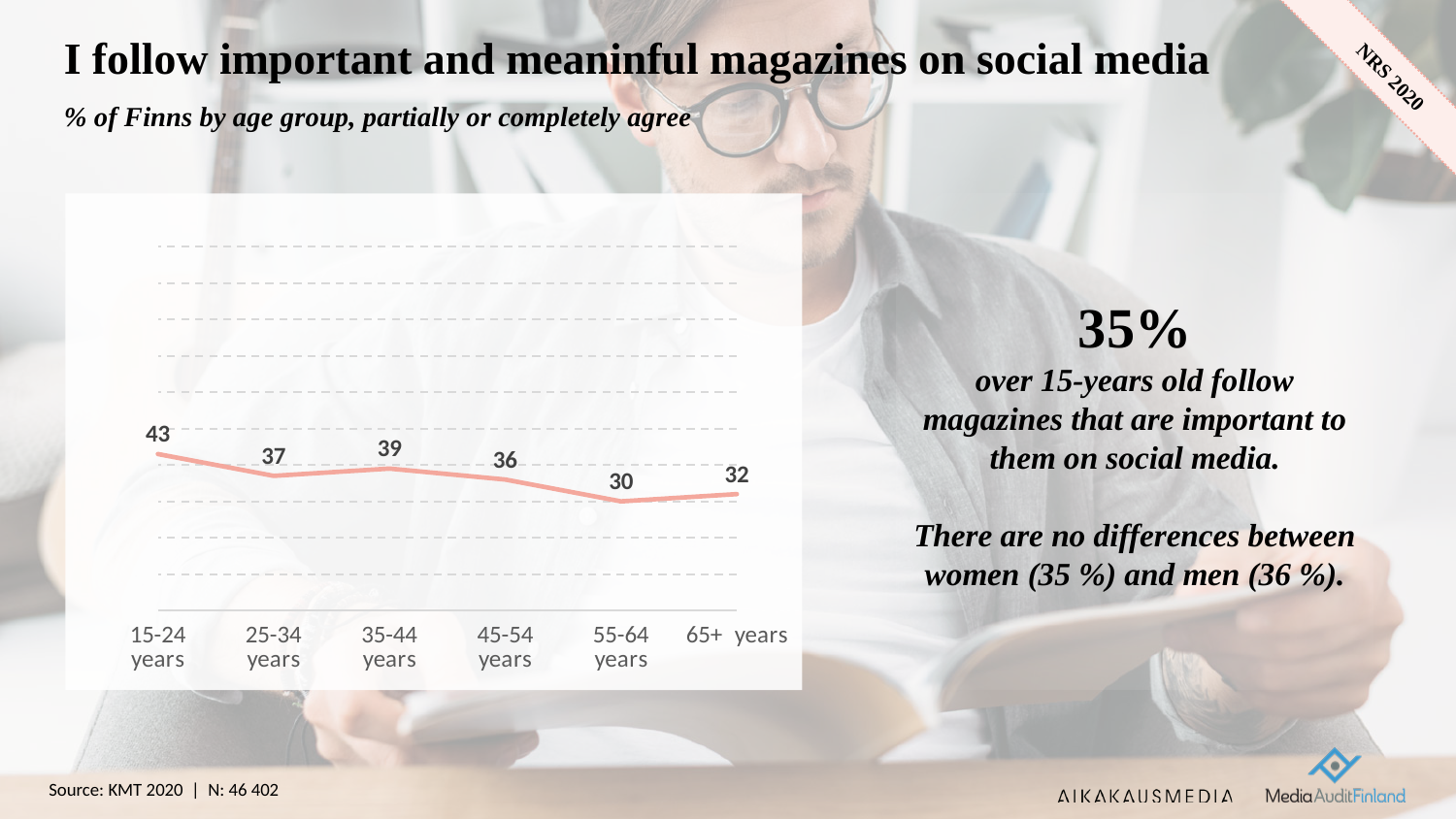
What is the subtitle of the chart? % of Finns by age group, partially or completely agree Which is larger, the value for 25-34 years or the value for 35-44 years? 35-44 years What kind of chart is shown on the slide? line chart What is the difference between the values for 35-44 years and 45-54 years? 3 What is the value for the 65+ years age group? 32 Which age group has the highest value? 15-24 years Which age group has the lowest value? 55-64 years What is the value for the 55-64 years age group? 30 What is the value for the 15-24 years age group? 43 Do the values generally rise or fall from the 15-24 years group to the 55-64 years group? fall What is the difference between the values for 15-24 years and 55-64 years? 13 How many age groups are plotted on the chart? 6